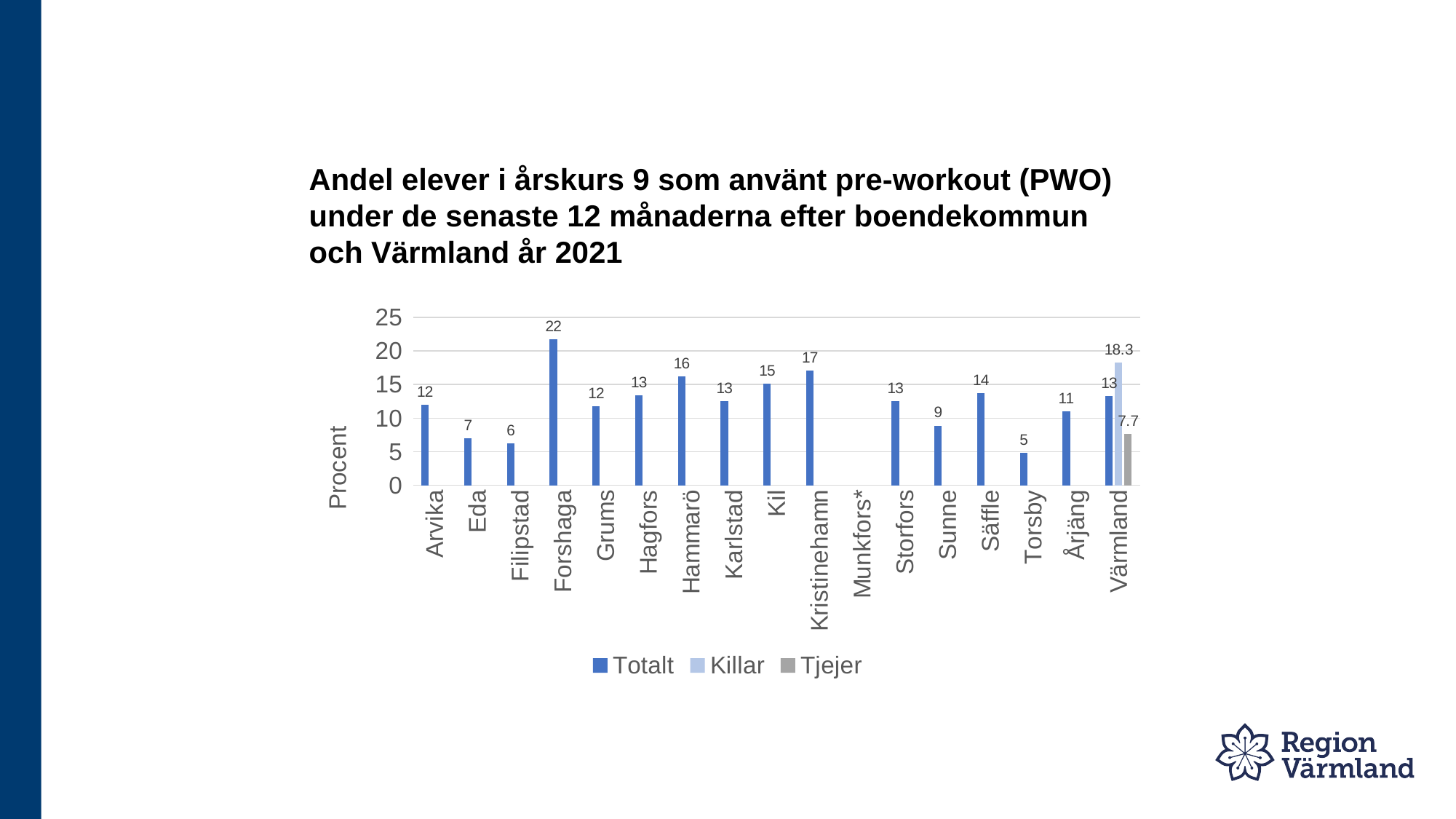
What is the Totalt value for Forshaga? 22 How many series does the legend list? 3 What is the Killar value for Värmland? 18.3 Which has a higher Totalt value, Eda or Sunne? Sunne Is the Totalt value for Forshaga greater or less than 20? greater Among the municipalities with a plotted bar, which has the lowest Totalt value? Torsby What is the difference between the Totalt values for Forshaga and Torsby? 17 What is the Tjejer value for Värmland? 7.7 What is the difference between the Killar and Tjejer values for Värmland? 10.6 What kind of chart is shown on the slide? Bar chart How many categories are shown on the x axis? 17 Which municipality has the highest Totalt value? Forshaga